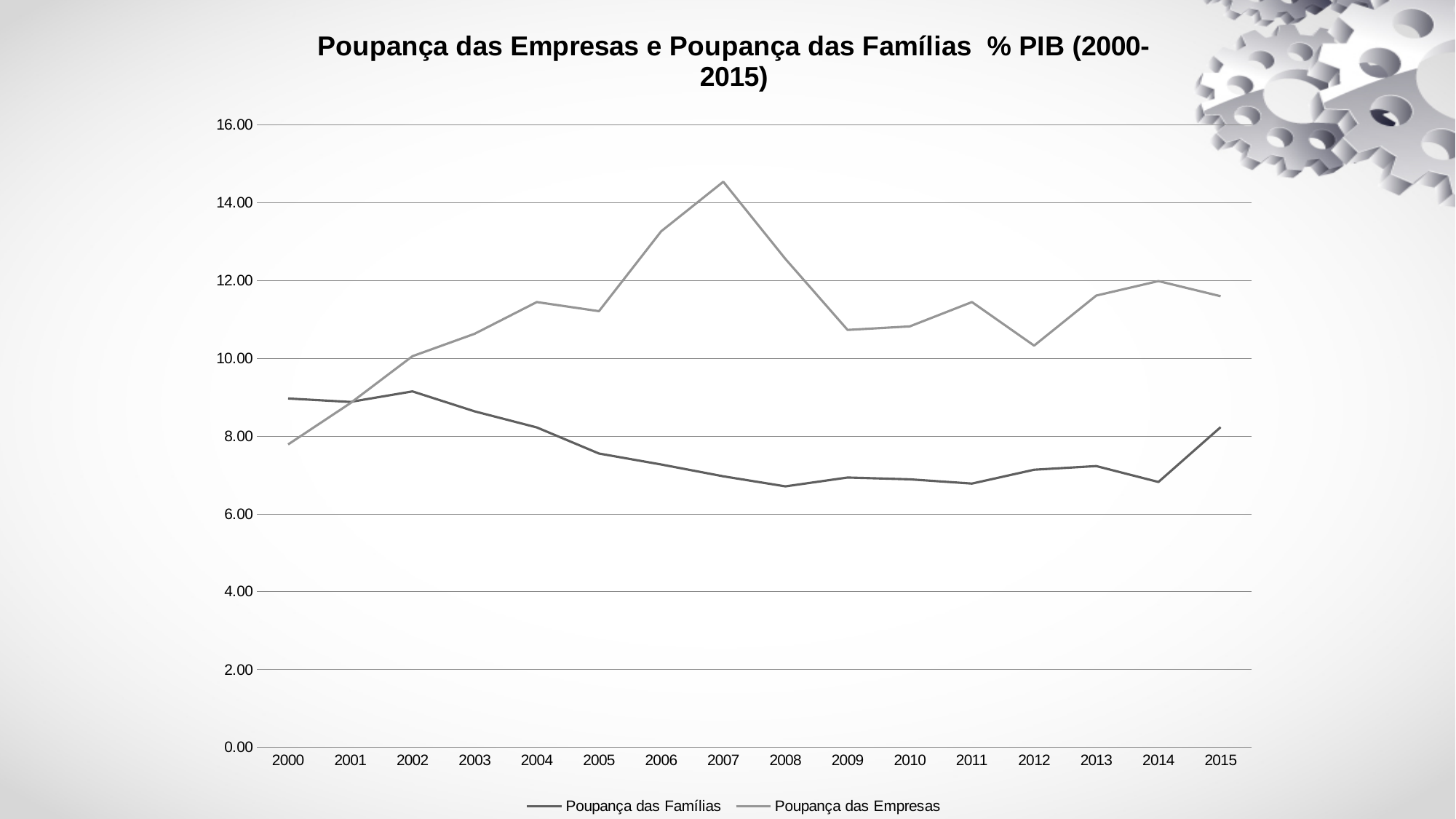
Is the value for Poupança das Famílias in 2008 greater or less than 8.00? less In which year does Poupança das Empresas have its lowest value? 2000 What is the title of the chart? Poupança das Empresas e Poupança das Famílias % PIB (2000-2015) What kind of chart is shown on the slide? line chart In which year does Poupança das Empresas reach its highest value? 2007 Is the value for Poupança das Empresas in 2014 greater or less than 10.00? greater How many years are plotted along the x axis? 16 Is the value for Poupança das Famílias in 2002 greater or less than 8.00? greater How many series does the legend list? 2 In 2000, which series has the larger value, Poupança das Famílias or Poupança das Empresas? Poupança das Famílias Does Poupança das Famílias rise or fall between 2002 and 2008? fall